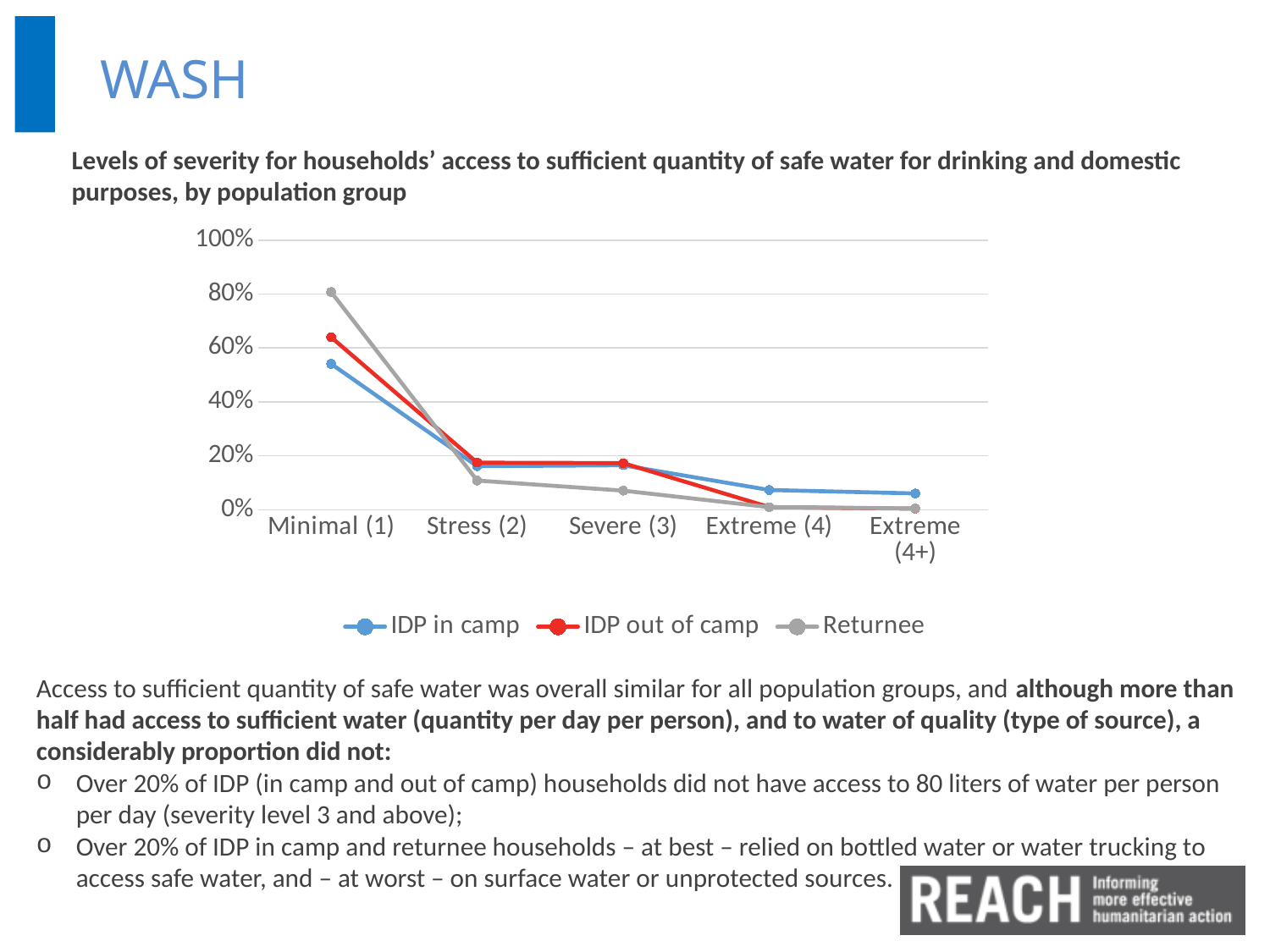
Which is larger at Minimal (1): IDP out of camp or IDP in camp? IDP out of camp Which is larger at Severe (3): IDP in camp or Returnee? IDP in camp Which series is drawn in red? IDP out of camp Which population group has the lowest value at Minimal (1)? IDP in camp Is the value for IDP in camp at Minimal (1) greater or less than 40%? greater How many series does the legend list? 3 How many severity categories are shown on the x axis? 5 Is the value for Returnee at Minimal (1) greater or less than 60%? greater What kind of chart is shown on the slide? line chart Which population group has the highest value at Minimal (1)? Returnee Do the values for IDP in camp generally rise or fall from Minimal (1) to Extreme (4+)? fall Is the value for Returnee at Stress (2) greater or less than 20%? less